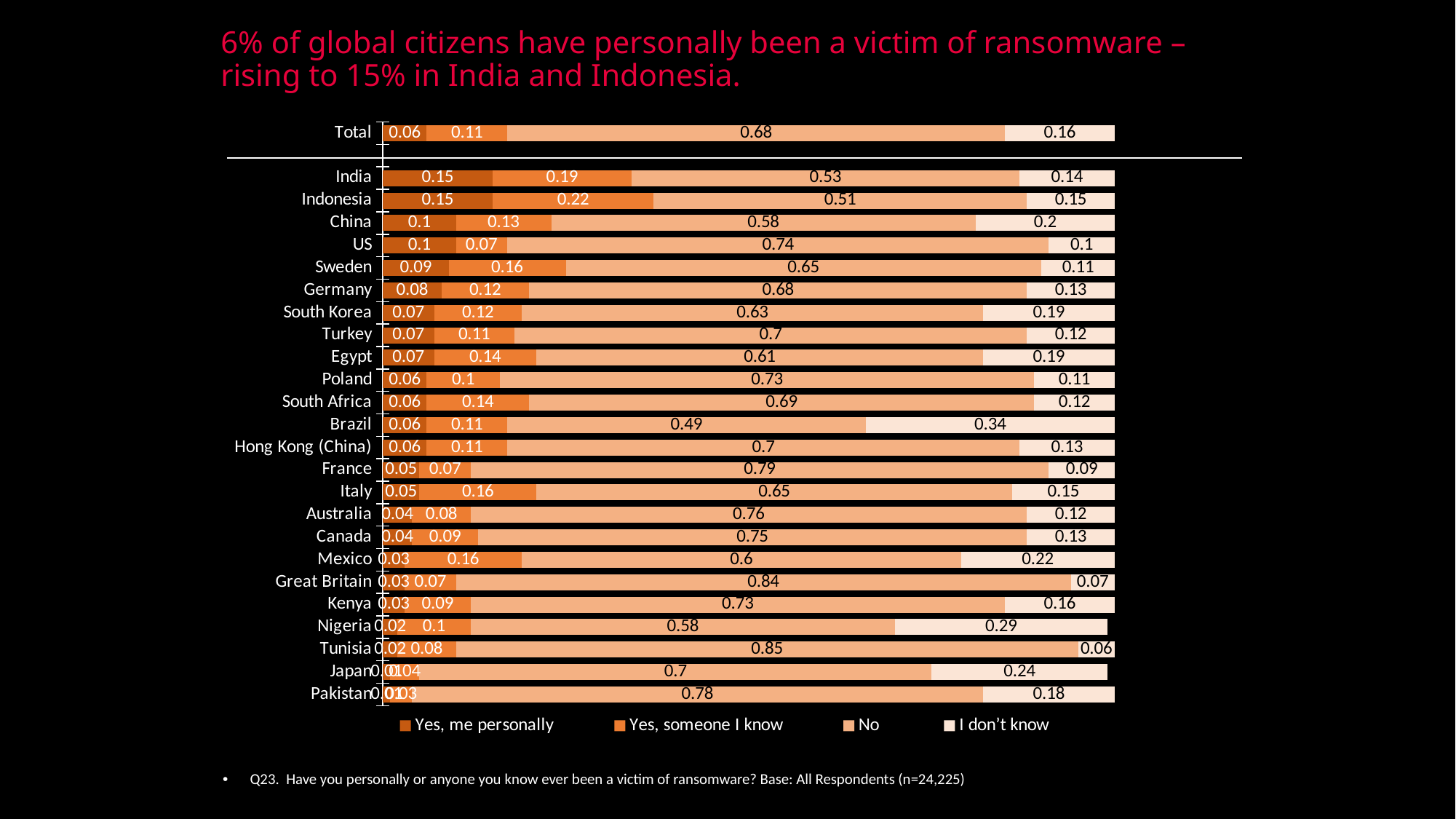
What is the difference between the "No" value for Great Britain and the "No" value for Brazil? 0.35 How many countries are listed below the Total bar? 24 What is the "Yes, me personally" value for India? 0.15 What is the "Yes, me personally" value for Mexico? 0.03 What is the value of the "No" segment for Total? 0.68 Which has a larger "No" value, France or the US? France Which country has the highest "I don't know" value? Brazil How many series does the legend list? 4 What is the "I don't know" value for Brazil? 0.34 What kind of chart is shown on the slide? Stacked bar chart What is the "Yes, someone I know" value for Indonesia? 0.22 Which country has the highest "No" value? Tunisia